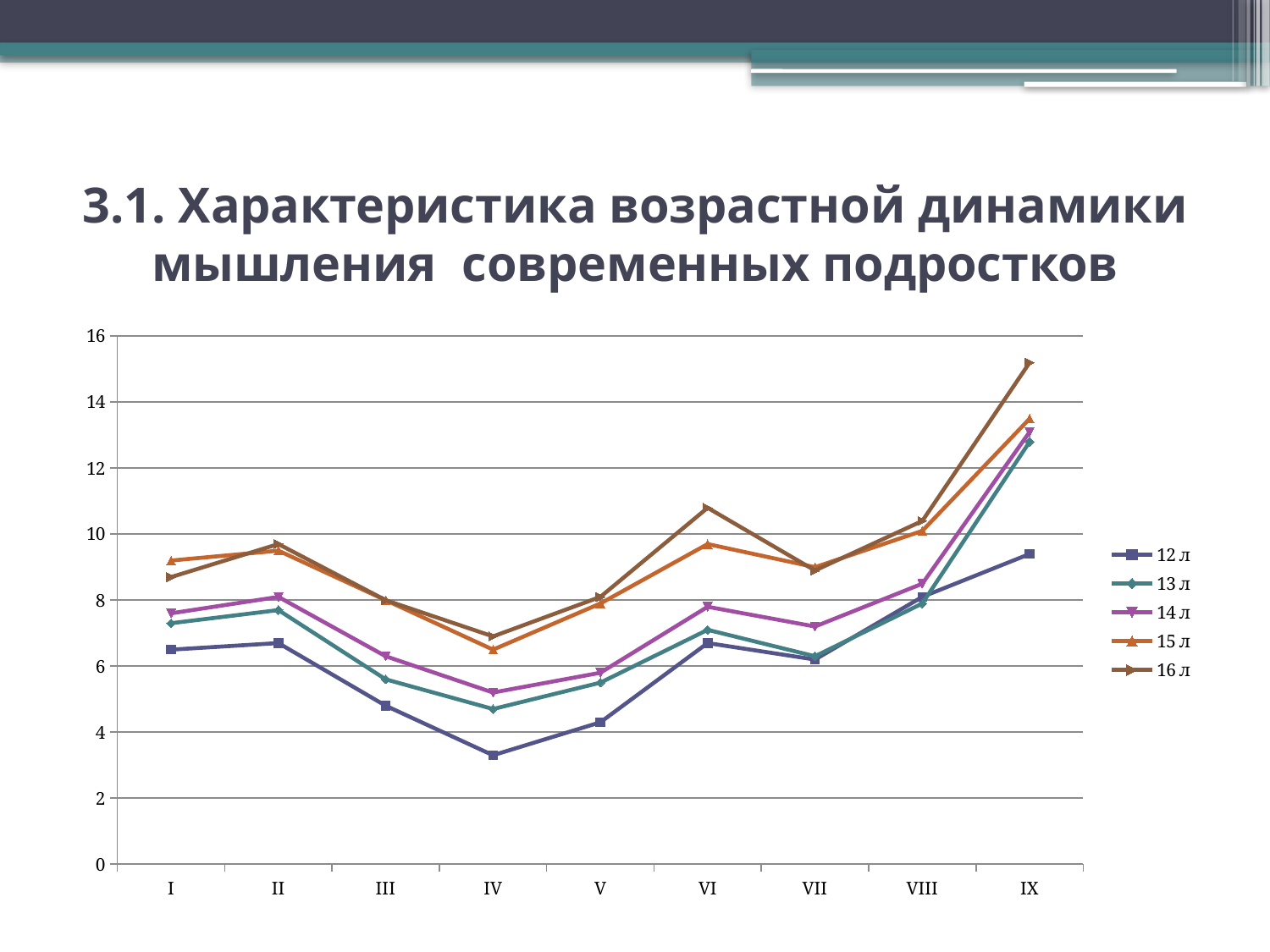
What kind of chart is shown on the slide? line chart At category VI, which series has the larger value: 15 л or 16 л? 16 л Which series are listed in the legend? 12 л, 13 л, 14 л, 15 л, 16 л Is the value for the 12 л series at category IV greater or less than 4? less At which category does the 16 л series reach its highest value? IX Is the value for the 16 л series at category IX greater or less than 14? greater How many series does the legend list? 5 At which category does the 12 л series reach its lowest value? IV How many categories are shown along the x axis? 9 Which series has the highest value at category IX? 16 л Is the value for the 16 л series at category VI greater or less than 10? greater At category IX, which series has the larger value: 12 л or 13 л? 13 л